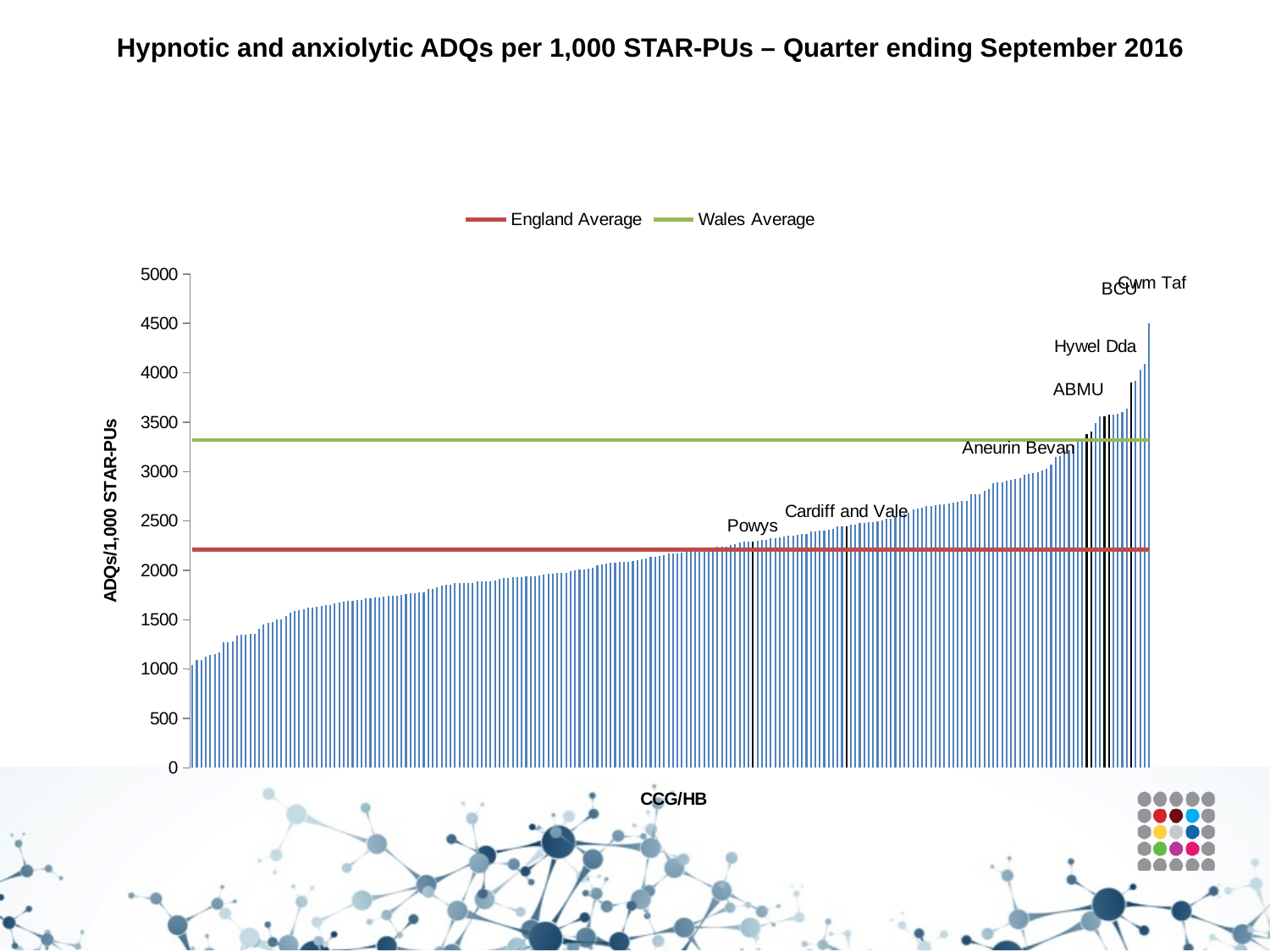
Do the bar values rise or fall from left to right along the x axis? rise How many series does the legend list? 2 Which has the larger value, Powys or Hywel Dda? Hywel Dda What kind of chart is shown on the slide? bar chart Is the Wales Average line greater or less than 3000? greater What is the title of the y axis? ADQs/1,000 STAR-PUs Is the value for Powys greater or less than 2000? greater Which is higher, the Wales Average or the England Average? Wales Average Is the value for Cardiff and Vale greater or less than 3000? less Which of the labelled Welsh health boards has the lowest value? Powys